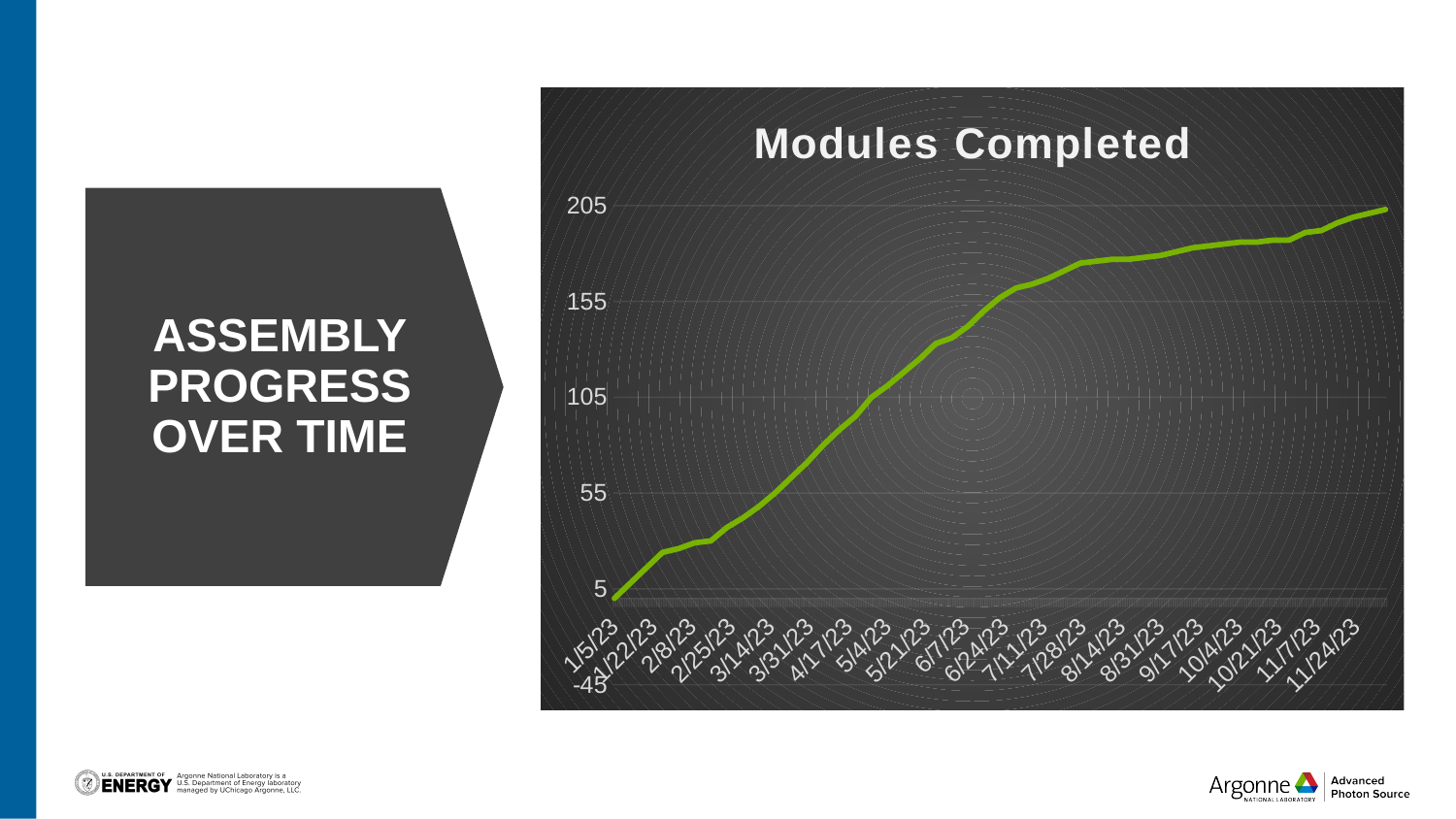
Is the value for 7/28/23 greater or less than 155? greater How many date labels are shown on the x axis of the chart? 20 Which has the larger value, 5/21/23 or 9/17/23? 9/17/23 What type of chart is shown on the slide? line chart Which date has the lowest value in the Modules Completed chart? 1/5/23 What is the title of the chart? Modules Completed Is the value for 2/8/23 greater or less than 55? less Is the value for 11/24/23 greater or less than 155? greater Do the values in the Modules Completed chart rise or fall from left to right along the x axis? rise